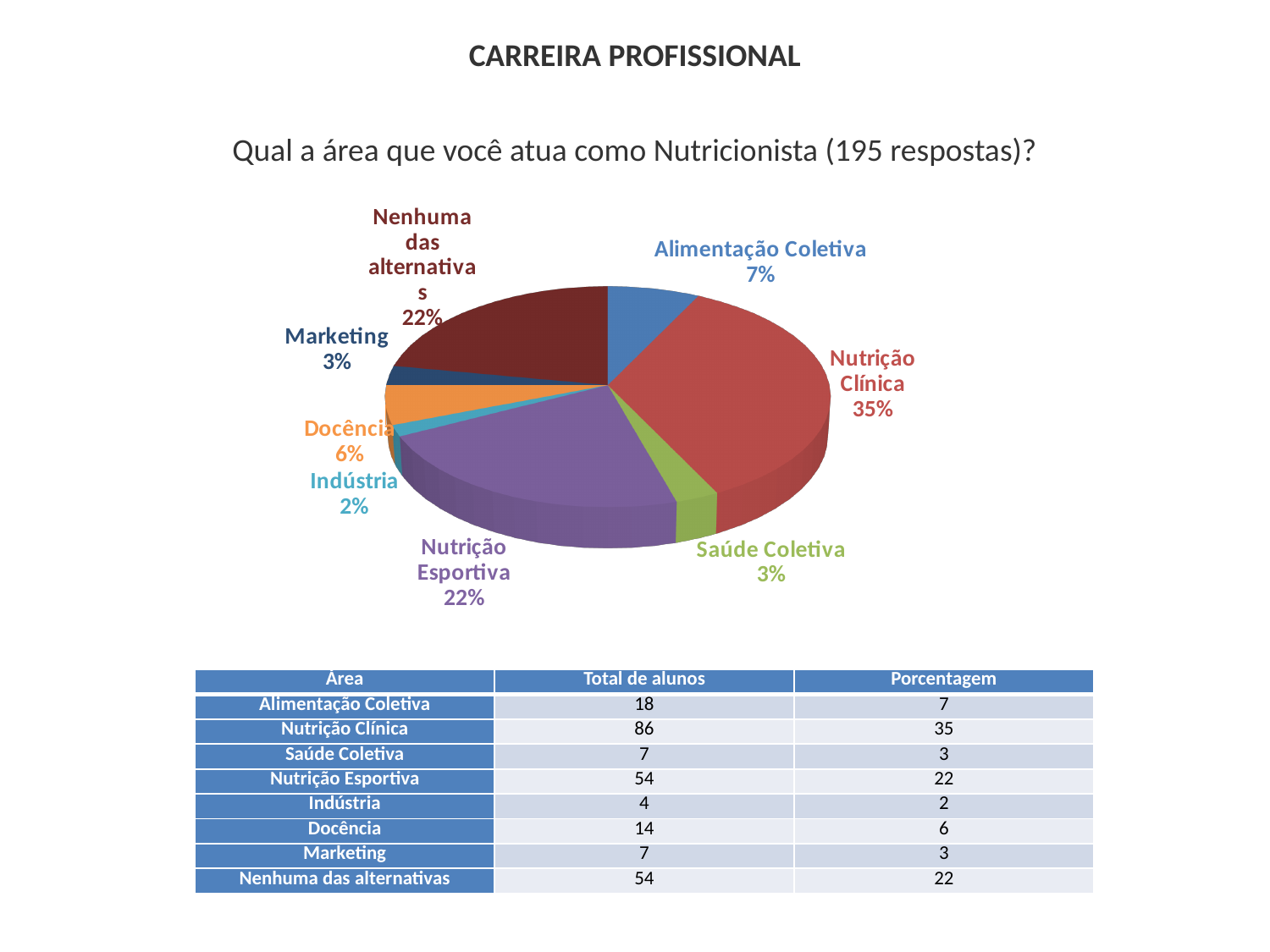
What percentage of the pie chart is Indústria? 2% Which two categories in the pie chart both have a share of 22%? Nutrição Esportiva and Nenhuma das alternativas How many categories are shown in the pie chart? 8 What percentage of the pie chart is Nutrição Clínica? 35% What question is the pie chart answering, according to the text above it? Qual a área que você atua como Nutricionista (195 respostas)? Which is larger in the pie chart, Docência or Marketing? Docência What is the difference in percentage points between Nutrição Clínica and Nutrição Esportiva in the pie chart? 13 What percentage of the pie chart is Alimentação Coletiva? 7% Which category has the smallest slice of the pie chart? Indústria What kind of chart is shown on the slide? Pie chart Which category has the largest slice of the pie chart? Nutrição Clínica What percentage of the pie chart is Docência? 6%